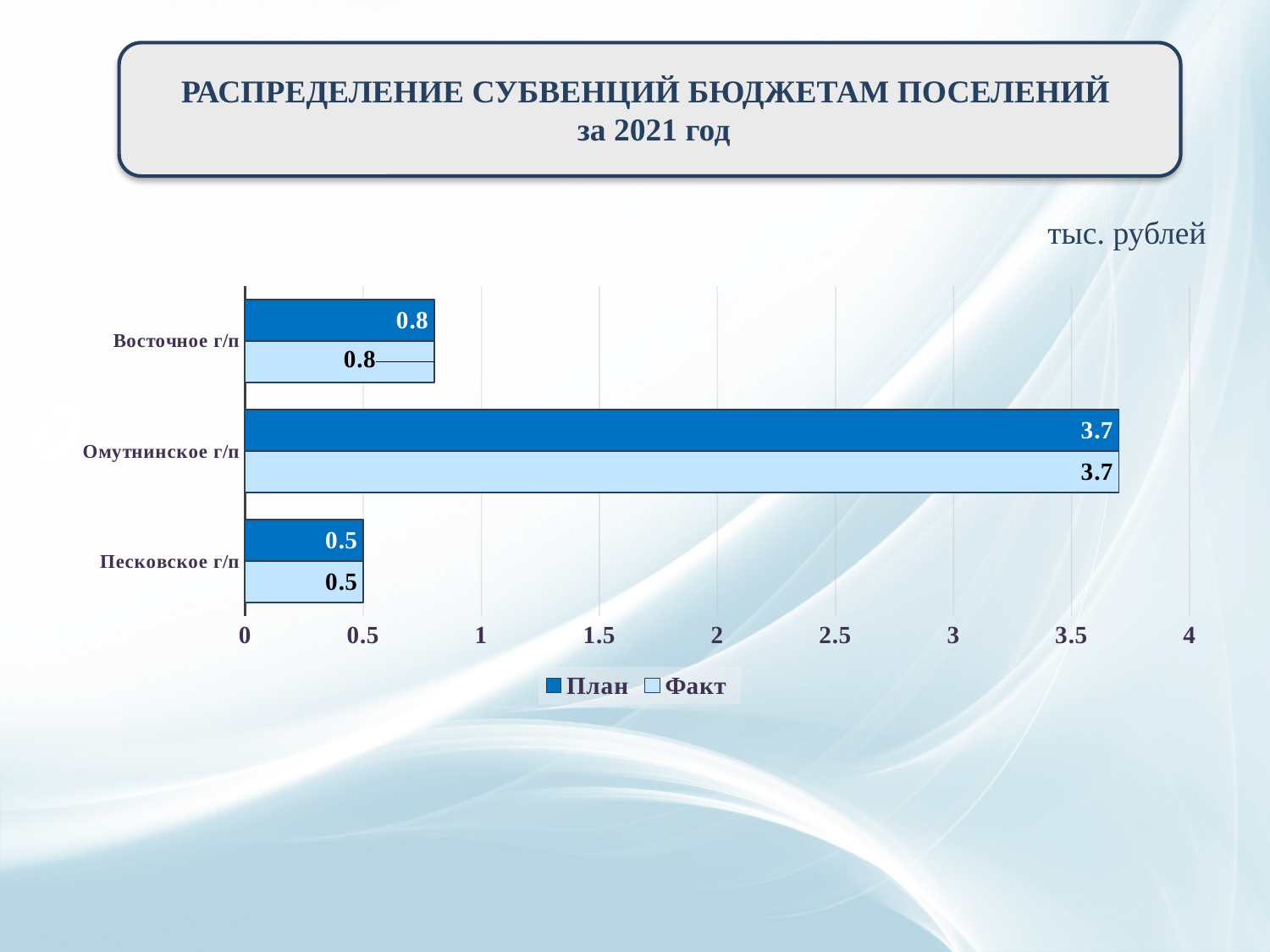
How many series does the legend list? 2 How many categories are shown on the chart? 3 What kind of chart is shown on the slide? bar chart Which category has the highest План value? Омутнинское г/п What is the План value for Омутнинское г/п? 3.7 What is the План value for Песковское г/п? 0.5 What is the Факт value for Восточное г/п? 0.8 What is the difference between the План values for Омутнинское г/п and Восточное г/п? 2.9 Which category has the lowest Факт value? Песковское г/п What unit is indicated above the chart? тыс. рублей Is the Факт value for Омутнинское г/п greater or less than 3? greater Which is larger, the Факт value for Восточное г/п or the Факт value for Песковское г/п? Восточное г/п